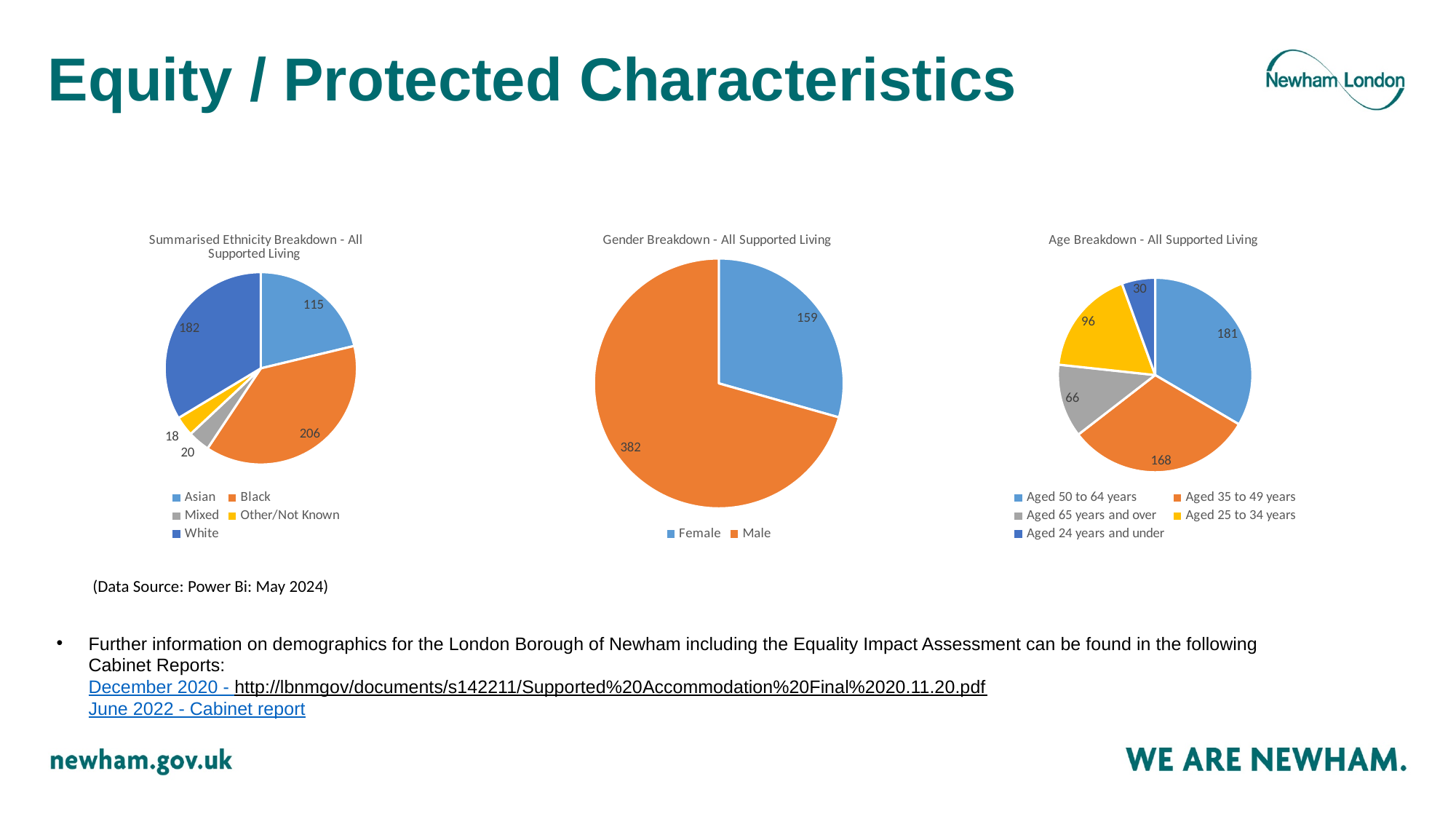
In the Summarised Ethnicity Breakdown - All Supported Living chart, what is the value for White? 182 What type of chart is the Gender Breakdown - All Supported Living chart? Pie chart In the Age Breakdown - All Supported Living chart, which is larger: Aged 50 to 64 years or Aged 65 years and over? Aged 50 to 64 years How many categories does the Summarised Ethnicity Breakdown - All Supported Living chart show? 5 How many charts are shown on the slide? 3 In the Gender Breakdown - All Supported Living chart, what is the difference between the Male and Female values? 223 In the Gender Breakdown - All Supported Living chart, what is the value for Male? 382 In the Age Breakdown - All Supported Living chart, what is the difference between Aged 50 to 64 years and Aged 35 to 49 years? 13 In the Age Breakdown - All Supported Living chart, what is the value for Aged 25 to 34 years? 96 How many categories does the Age Breakdown - All Supported Living chart show? 5 In the Age Breakdown - All Supported Living chart, which category has the smallest value? Aged 24 years and under In the Summarised Ethnicity Breakdown - All Supported Living chart, which category has the largest value? Black